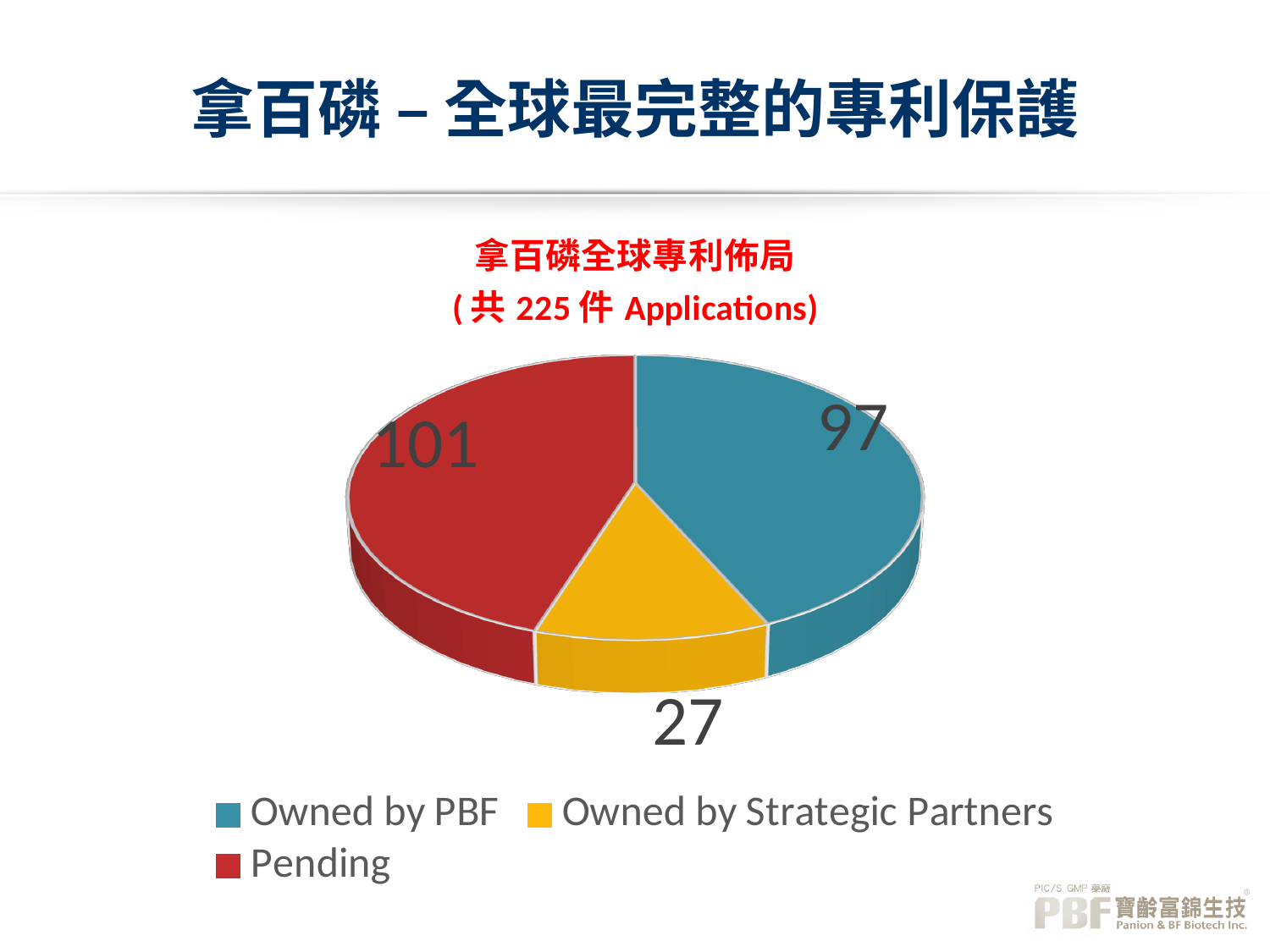
What share of the total 225 applications is Owned by Strategic Partners? 12% What colour represents the Pending slice in the pie chart? red How many applications are Pending? 101 Which is larger: Owned by PBF or Owned by Strategic Partners? Owned by PBF Which category has the smallest number of applications? Owned by Strategic Partners What is the difference between applications Owned by PBF and those Owned by Strategic Partners? 70 Which category has the largest number of applications? Pending What is the difference between the Pending applications and those Owned by PBF? 4 What kind of chart is shown on the slide? pie chart How many applications are Owned by Strategic Partners? 27 How many applications are Owned by PBF? 97 How many slices does the pie chart have? 3